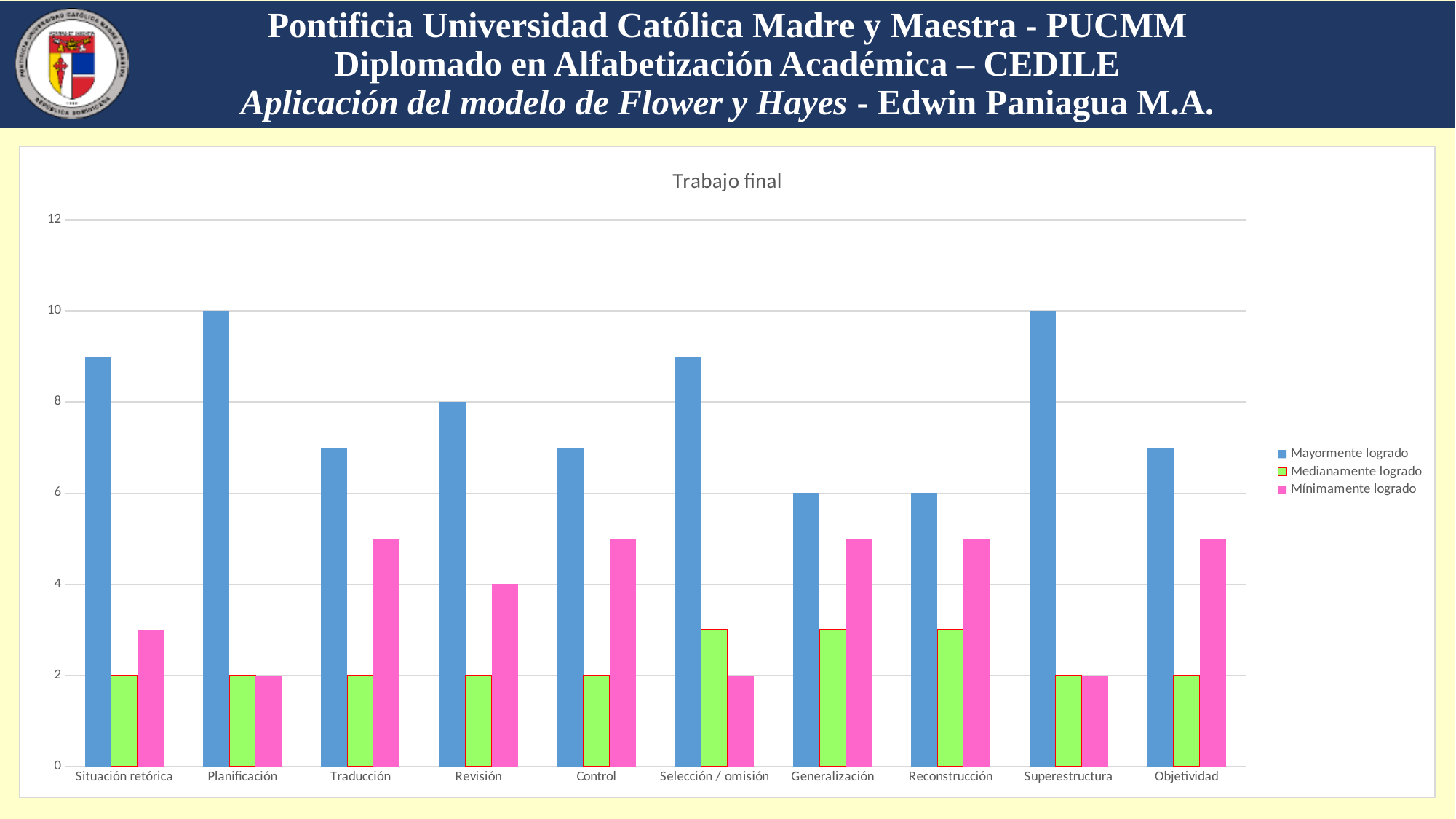
For Generalización, which is larger: Medianamente logrado or Mínimamente logrado? Mínimamente logrado What is the value of Mayormente logrado for Planificación? 10 How many series does the legend list? 3 What is the value of Mayormente logrado for Revisión? 8 Is the value of Mayormente logrado for Situación retórica greater or less than 8? greater What is the difference between Mayormente logrado and Medianamente logrado for Planificación? 8 How many categories are shown on the x axis? 10 What kind of chart is shown on the slide? bar chart What is the value of Mayormente logrado for Generalización? 6 What is the value of Mínimamente logrado for Revisión? 4 Is the value of Mínimamente logrado for Traducción greater or less than 4? greater What is the title of the chart? Trabajo final